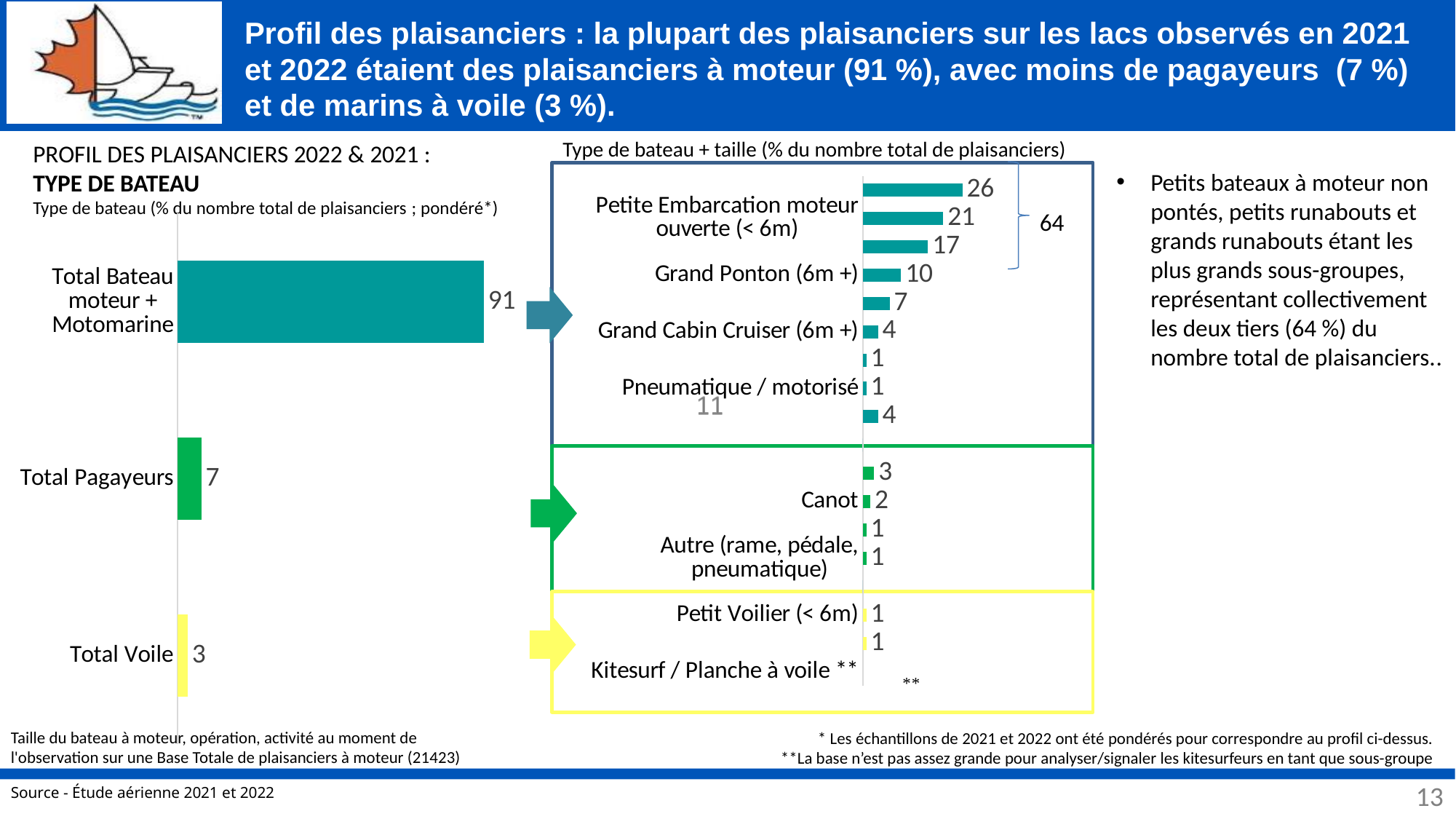
In the left chart (Type de bateau), what is the difference between Total Pagayeurs and Total Voile? 4 In the left chart (Type de bateau), which category has the lowest value? Total Voile In the left chart (Type de bateau), what is the value for Total Bateau moteur + Motomarine? 91 In the right chart (Type de bateau + taille), what is the value for Grand Ponton (6m +)? 10 In the right chart (Type de bateau + taille), which is larger: Grand Ponton (6m +) or Canot? Grand Ponton (6m +) What kind of chart is the left chart (Type de bateau)? Bar chart In the left chart (Type de bateau), what is the value for Total Pagayeurs? 7 In the right chart (Type de bateau + taille), what is the value for Grand Cabin Cruiser (6m +)? 4 In the left chart (Type de bateau), what is the value for Total Voile? 3 In the left chart (Type de bateau), how many categories are plotted? 3 In the right chart (Type de bateau + taille), what is the value for Canot? 2 In the left chart (Type de bateau), which category has the highest value? Total Bateau moteur + Motomarine